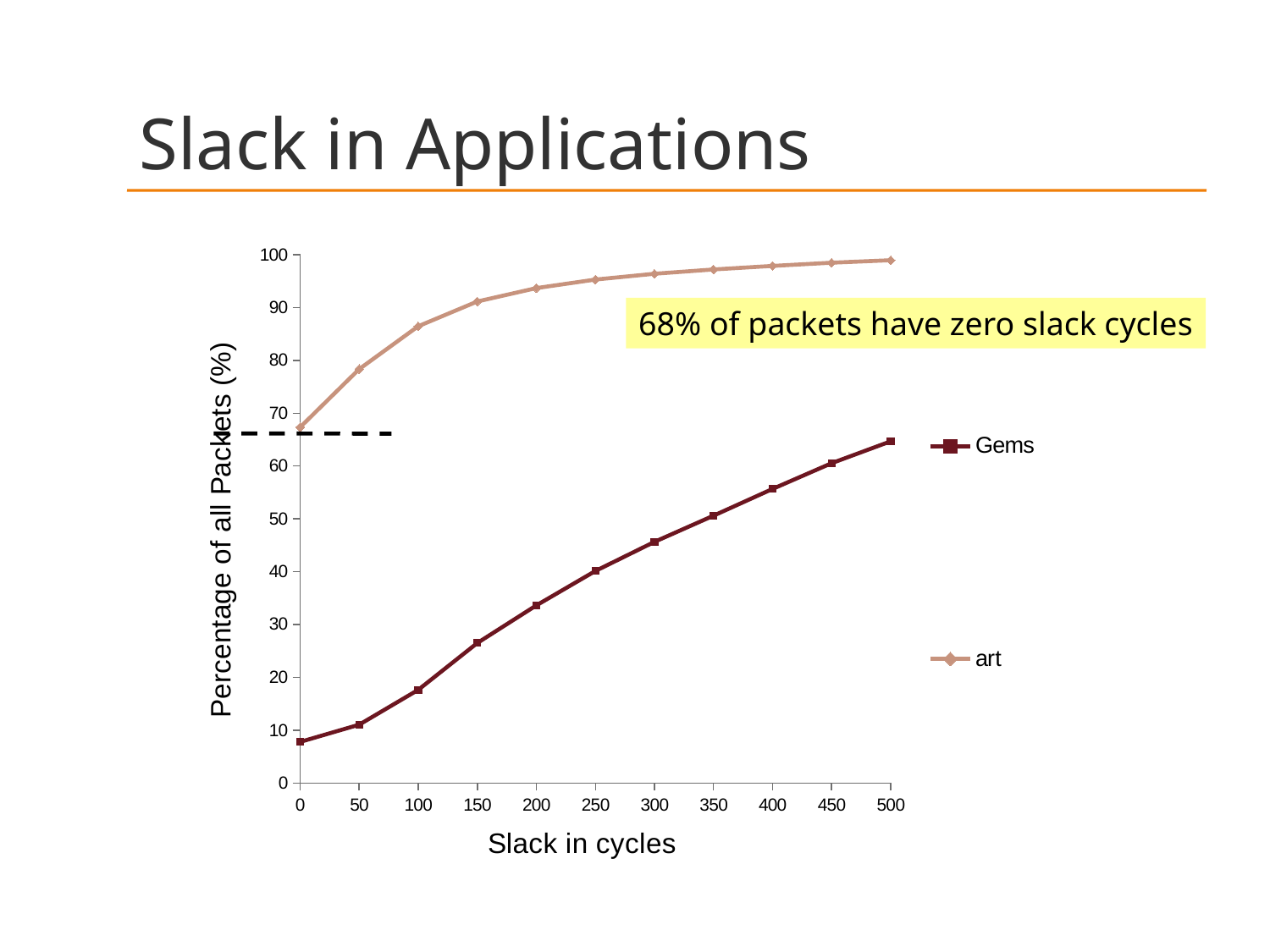
How many series does the legend list? 2 Is the value for Gems at 0 slack cycles greater or less than 10? less Which series has the higher percentage of packets at 500 slack cycles, Gems or art? art Is the value for Gems at 100 slack cycles greater or less than 20? less What is the label of the x axis? Slack in cycles Is the value for art at 500 slack cycles greater or less than 90? greater What kind of chart is shown on the slide? line chart Does the Gems series rise or fall as slack in cycles increases? rises According to the annotation on the slide, what percentage of packets have zero slack cycles? 68% How many data points are plotted along the x axis for each series? 11